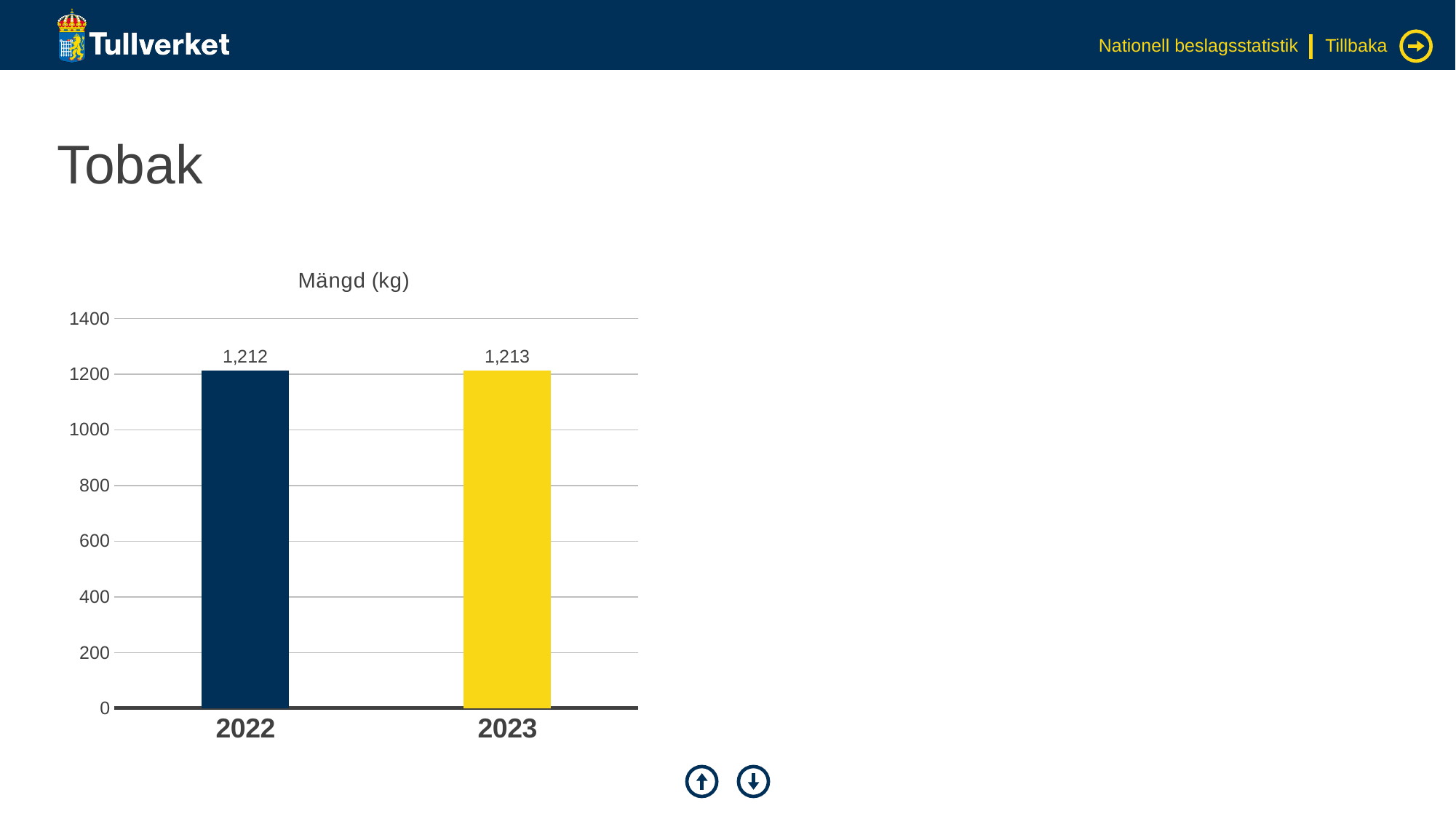
What is the value for 2022 in the Mängd (kg) chart? 1,212 What is the difference between the 2023 and 2022 values in the Mängd (kg) chart? 1 Is the value for 2022 greater or less than 1000? greater What kind of chart is shown on the slide? Bar chart What colour is the bar for 2023? Yellow Do the values rise or fall from 2022 to 2023? Rise Which year has the higher value in the Mängd (kg) chart? 2023 What is the title of the chart? Mängd (kg) What is the value for 2023 in the Mängd (kg) chart? 1,213 How many years are shown in the Mängd (kg) chart? 2 Is the value for 2023 greater or less than 1400? less Which year has the lower value in the Mängd (kg) chart? 2022